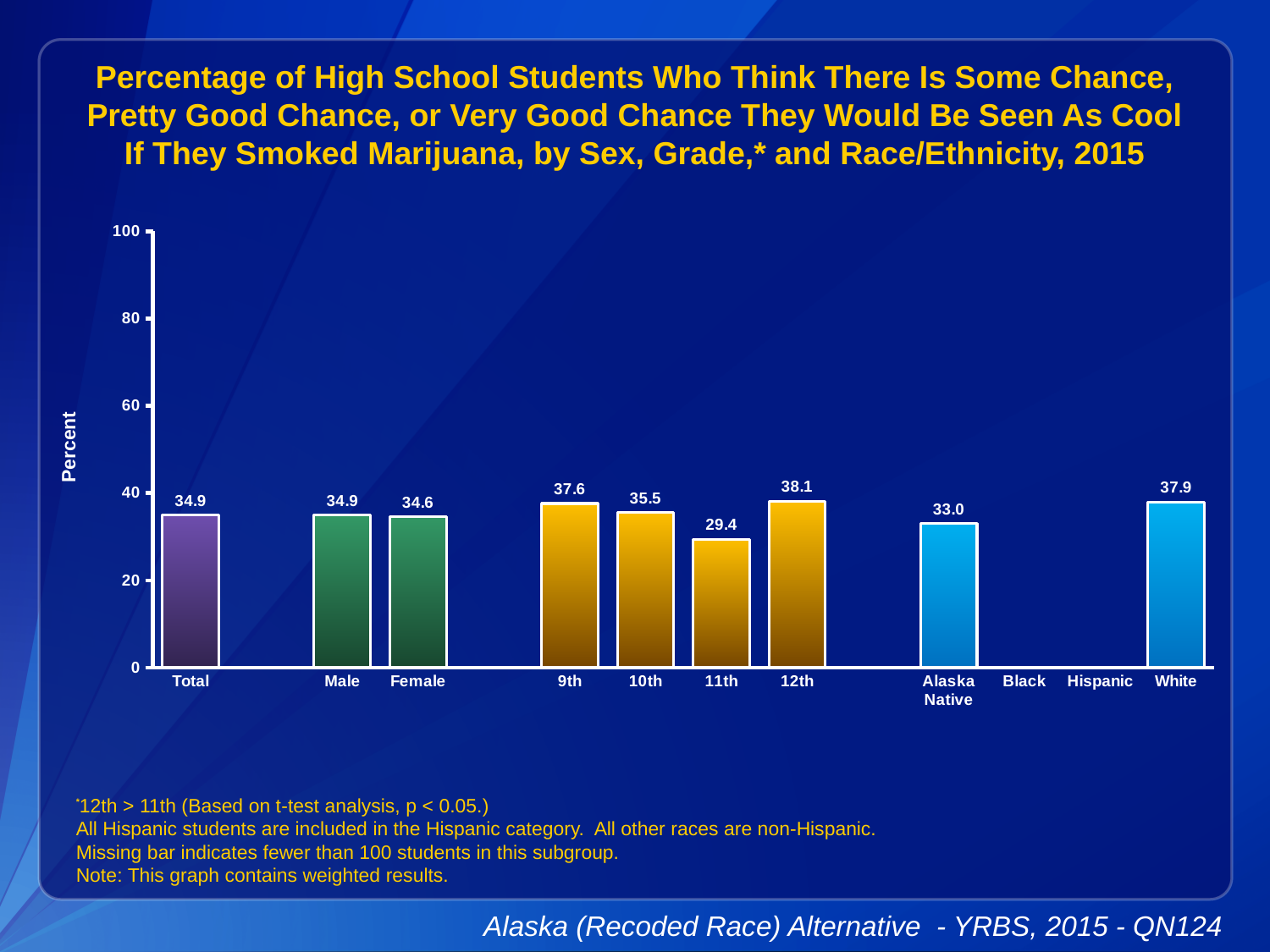
Which category with a plotted bar has the lowest value? 11th Is the value for White greater or less than 40? less What is the value for 11th grade? 29.4 What is the difference between the values for 12th and 11th grade? 8.7 What is the value for Alaska Native? 33.0 What is the value for Total? 34.9 Which categories have no bar shown? Black and Hispanic What kind of chart is shown? bar chart What is the label on the y axis? Percent Which category has the highest value? 12th How many categories have a plotted bar? 9 Which is larger, the value for 9th grade or the value for 10th grade? 9th